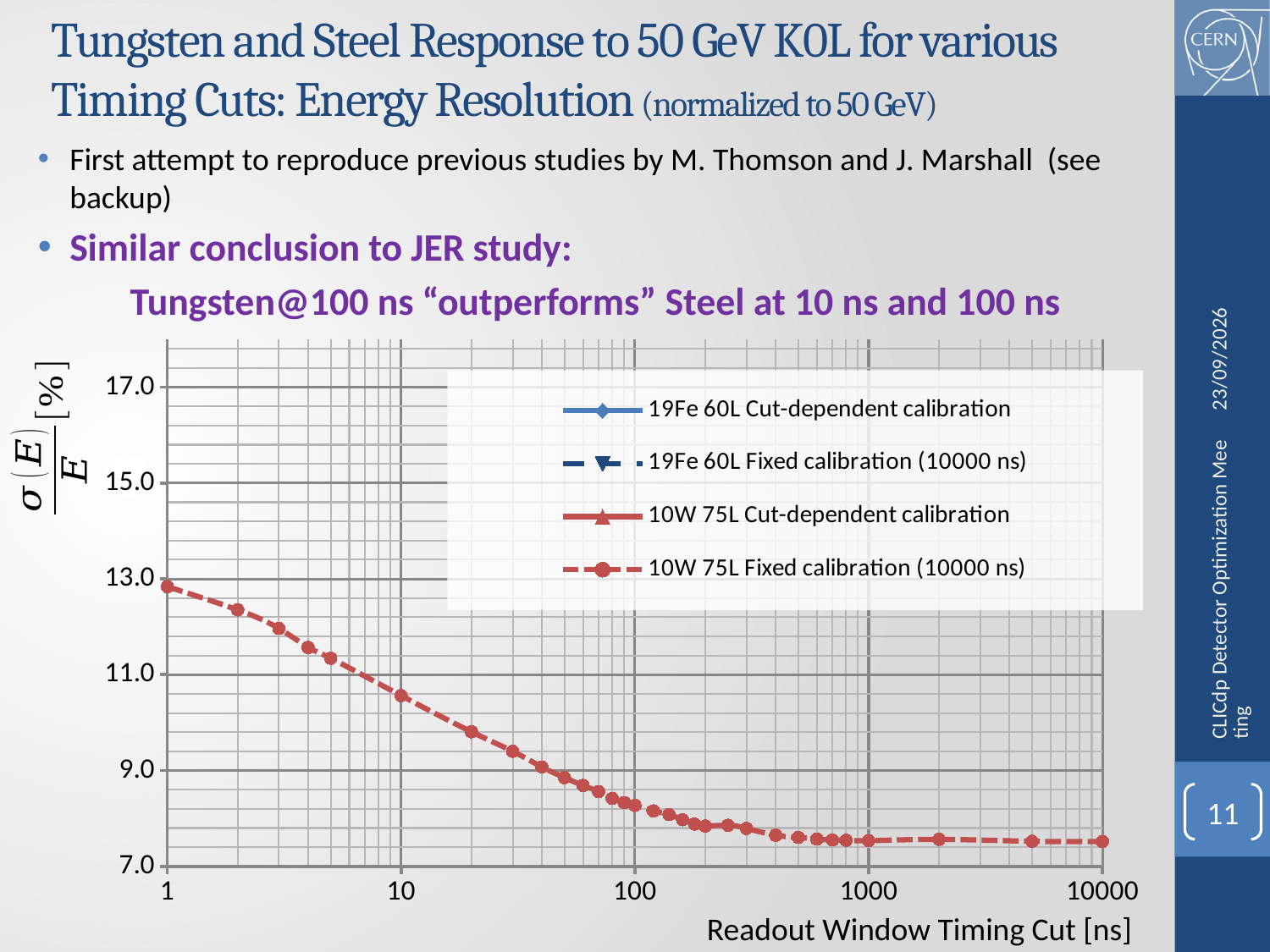
Which legend entry is drawn with a red dashed line and circle markers? 10W 75L Fixed calibration (10000 ns) What is the label of the x axis of the chart? Readout Window Timing Cut [ns] Is the plotted energy resolution at a timing cut of 10 ns greater or less than 9.0? greater Does the plotted energy resolution rise or fall as the readout window timing cut increases along the x axis? fall At which timing cut on the x axis is the plotted energy resolution highest? 1 ns What kind of chart is shown on the slide? line chart How many series does the chart legend list? 4 Is the plotted energy resolution at a timing cut of 100 ns greater or less than 9.0? less Is the plotted energy resolution at a timing cut of 1 ns greater or less than 11.0? greater Which has the larger plotted energy resolution: the timing cut of 1 ns or the timing cut of 1000 ns? 1 ns Which has the larger plotted energy resolution: the timing cut of 10 ns or the timing cut of 100 ns? 10 ns